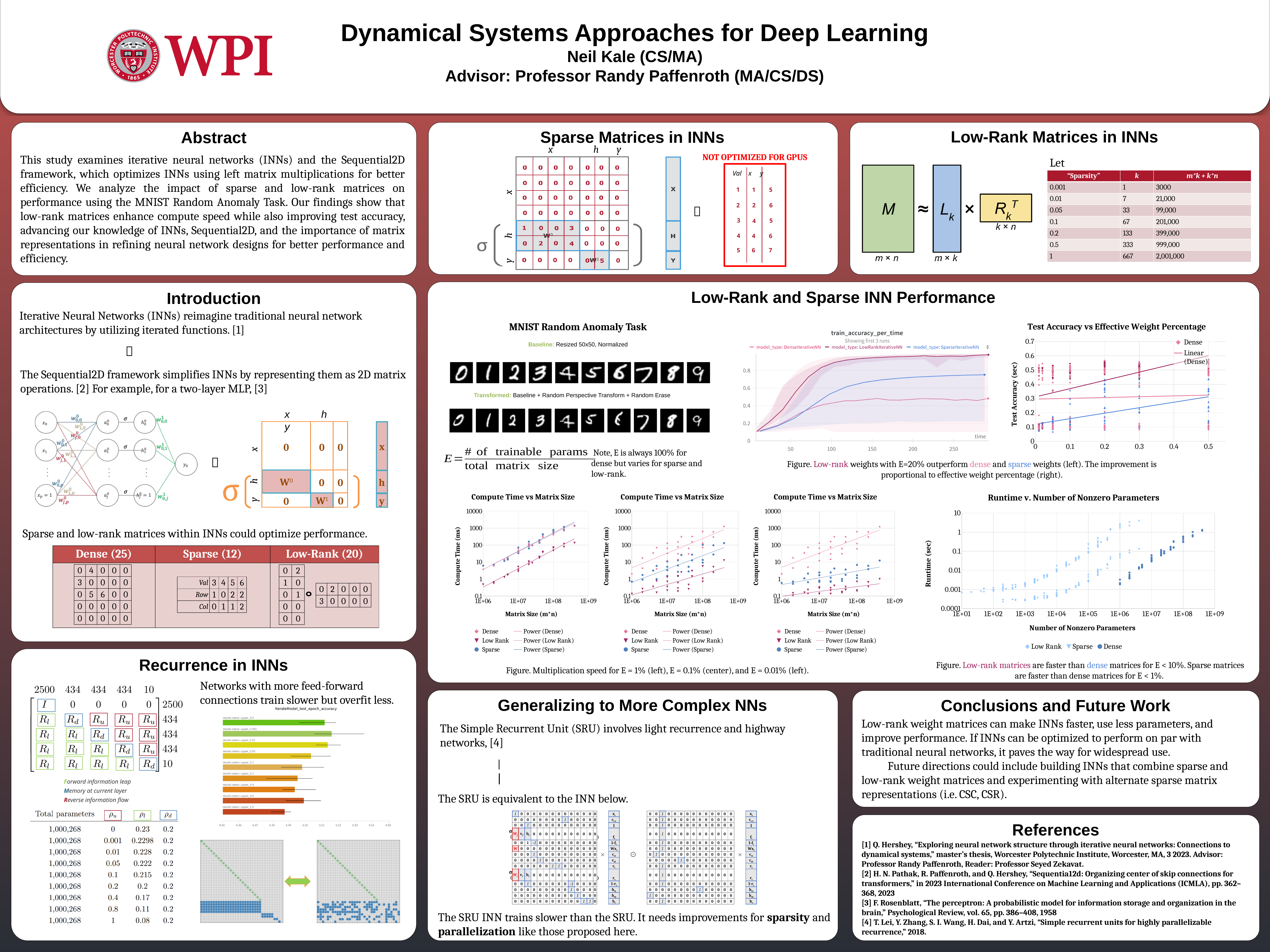
How many bars does the 'IterateModel_test_epoch_accuracy' chart show? 9 In the 'train_accuracy_per_time' chart, which model_type reaches the highest accuracy at the end of the time axis? LowRankIterativeNN How many series does the legend of the 'Runtime v. Number of Nonzero Parameters' chart list? 3 What is the y-axis label of the 'Test Accuracy vs Effective Weight Percentage' chart? Test Accuracy (sec) In the 'train_accuracy_per_time' chart, is the final value for model_type: SparseIterativeNN greater or less than 0.8? less How many series does the legend of the 'train_accuracy_per_time' chart list? 3 What kind of chart is the 'IterateModel_test_epoch_accuracy' chart in the Recurrence in INNs section? bar chart In the 'IterateModel_test_epoch_accuracy' chart, is the value for model.name: upper_0.0 greater or less than 0.50? greater How many entries does the legend of the leftmost 'Compute Time vs Matrix Size' chart list? 6 In the 'IterateModel_test_epoch_accuracy' chart, do the bars generally get longer or shorter as the upper value increases from 0.0 to 1.0? shorter In the 'IterateModel_test_epoch_accuracy' chart, which model name has the shortest bar? model.name: upper_1.0 In the 'train_accuracy_per_time' chart, which has the higher final accuracy, DenseIterativeNN or SparseIterativeNN? SparseIterativeNN